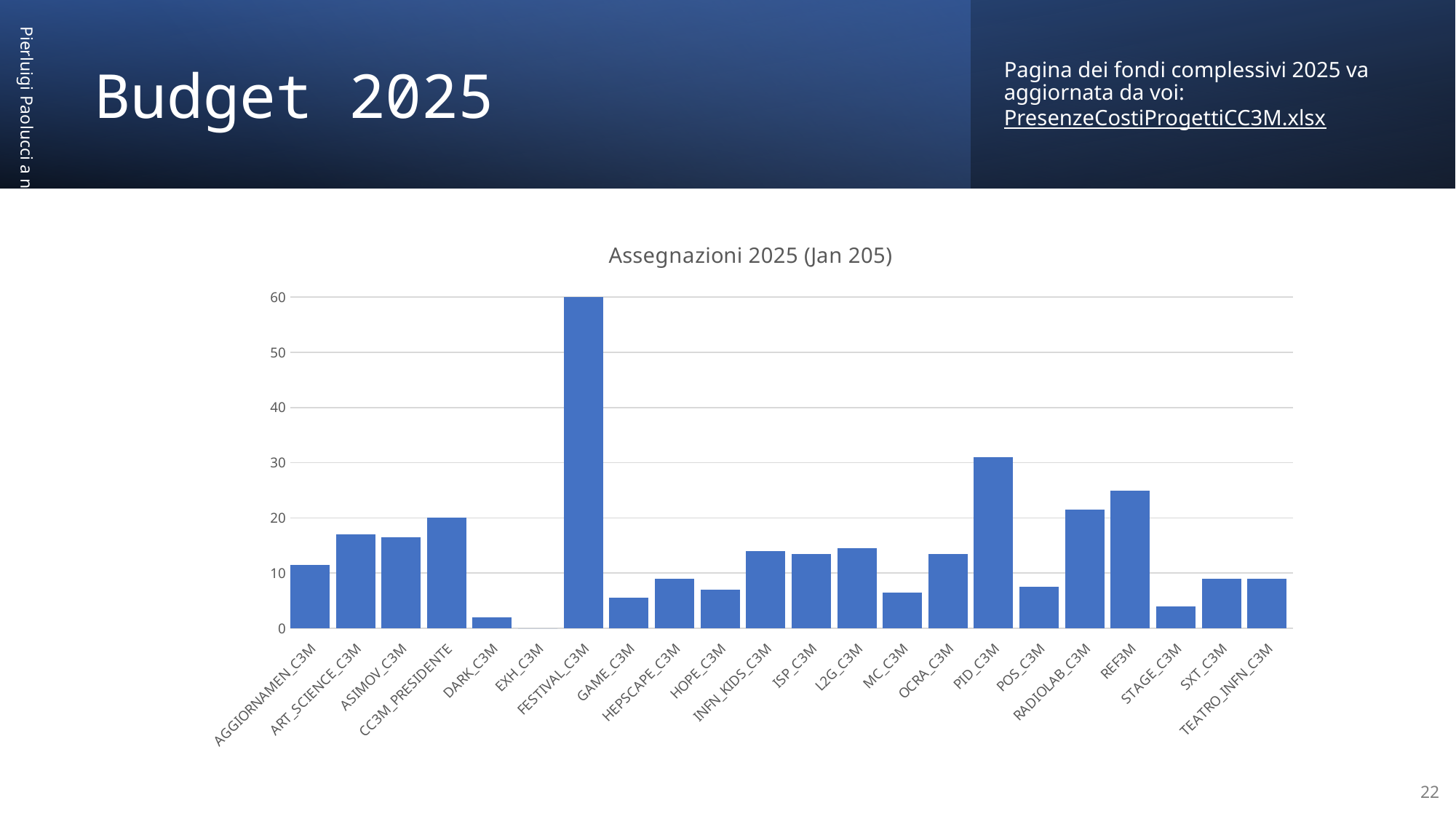
How many categories are shown on the x axis of the chart? 22 What is the value for CC3M_PRESIDENTE? 20 What kind of chart is shown on the slide? bar chart What is the value for FESTIVAL_C3M? 60 Is the value for REF3M greater or less than 20? greater Which is larger, the value for PID_C3M or the value for RADIOLAB_C3M? PID_C3M Which is larger, the value for ART_SCIENCE_C3M or the value for GAME_C3M? ART_SCIENCE_C3M Which category has the highest value in the chart? FESTIVAL_C3M Is the value for PID_C3M greater or less than 20? greater What is the title of the chart? Assegnazioni 2025 (Jan 205) Is the value for DARK_C3M greater or less than 10? less Which category has the lowest value in the chart? EXH_C3M